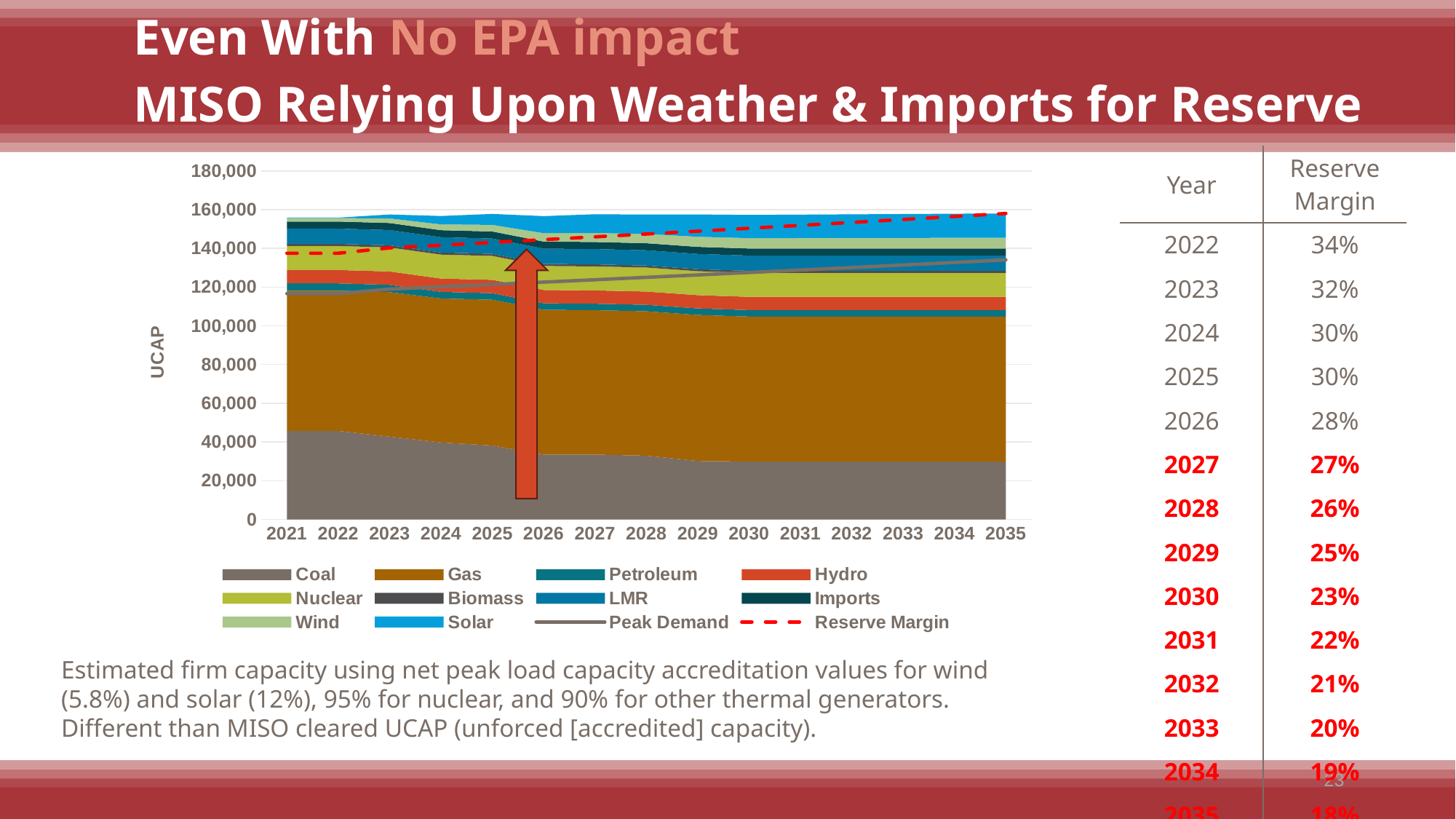
Does the Peak Demand line rise or fall from 2021 to 2035? rise Which series occupies the largest area of the chart, Coal or Gas? Gas Is the value for Coal in 2021 greater or less than 40,000? greater Is the top of the stacked areas in 2021 greater or less than 140,000? greater What is the first year shown on the chart's x axis? 2021 Is the value for Coal in 2035 greater or less than 40,000? less What kind of chart is shown on the slide? stacked area chart Does the Coal area rise or fall from 2021 to 2035? fall What is the label of the chart's y axis? UCAP How many series does the chart's legend list? 12 How many years are shown along the x axis of the chart? 15